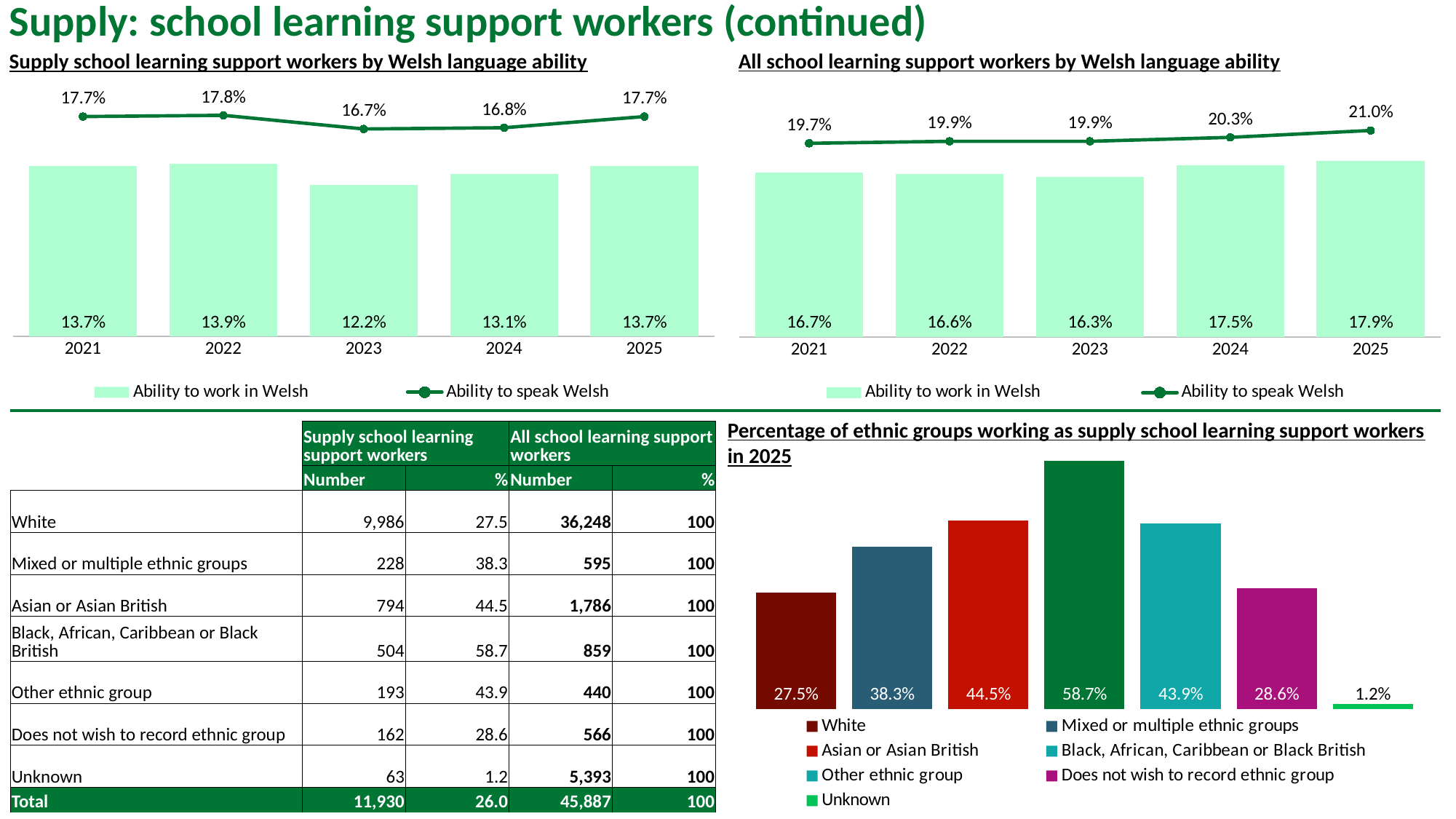
In the chart 'All school learning support workers by Welsh language ability', what is the 'Ability to speak Welsh' value for 2025? 21.0% In the chart 'Percentage of ethnic groups working as supply school learning support workers in 2025', what is the value for 'Mixed or multiple ethnic groups'? 38.3% In the chart 'All school learning support workers by Welsh language ability', what is the difference between the 'Ability to speak Welsh' values for 2025 and 2021? 1.3 percentage points In the chart 'All school learning support workers by Welsh language ability', how many years are shown on the x axis? 5 In the chart 'Supply school learning support workers by Welsh language ability', what is the 'Ability to work in Welsh' value for 2023? 12.2% In the chart 'Supply school learning support workers by Welsh language ability', what is the 'Ability to speak Welsh' value for 2022? 17.8% In the chart 'Supply school learning support workers by Welsh language ability', which year has the lowest 'Ability to work in Welsh' value? 2023 What kind of chart is 'Percentage of ethnic groups working as supply school learning support workers in 2025'? Bar chart In the chart 'Percentage of ethnic groups working as supply school learning support workers in 2025', which is larger: the value for 'Asian or Asian British' or the value for 'Other ethnic group'? Asian or Asian British In the chart 'All school learning support workers by Welsh language ability', which year has the highest 'Ability to work in Welsh' value? 2025 In the chart 'Percentage of ethnic groups working as supply school learning support workers in 2025', which ethnic group has the highest value? Black, African, Caribbean or Black British In the chart 'Supply school learning support workers by Welsh language ability', how many series does the legend list? 2